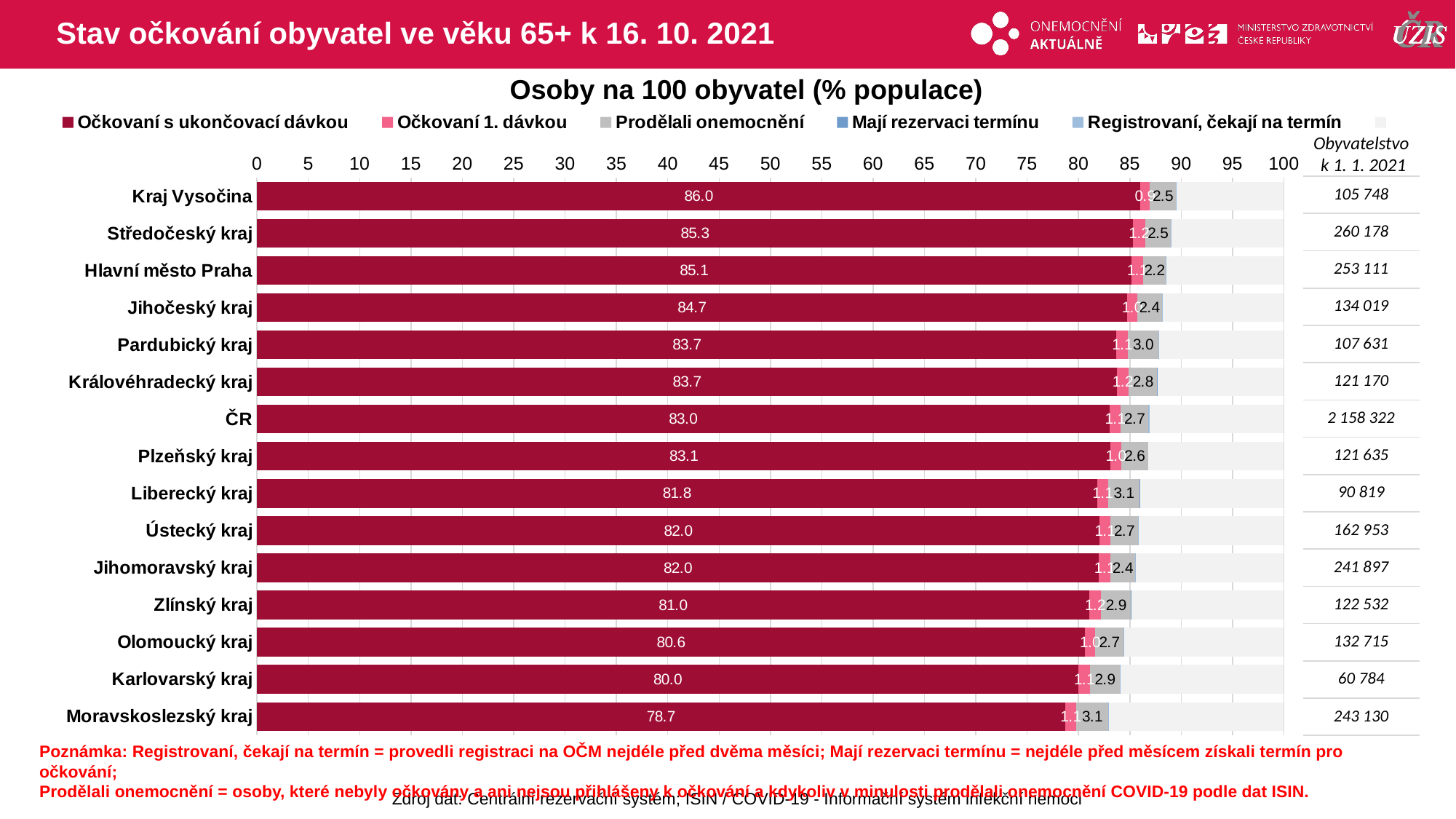
What is the difference between Kraj Vysočina and Moravskoslezský kraj in the 'Očkovaní s ukončovací dávkou' series? 7.3 What is the difference between Olomoucký kraj and Karlovarský kraj in the 'Očkovaní s ukončovací dávkou' series? 0.6 What is the value for Pardubický kraj in the 'Prodělali onemocnění' series? 3.0 Which category has the highest value in the 'Očkovaní s ukončovací dávkou' series? Kraj Vysočina What kind of chart is shown on the slide? Bar chart What is the value for Karlovarský kraj in the 'Očkovaní s ukončovací dávkou' series? 80.0 What is the value for Kraj Vysočina in the 'Očkovaní s ukončovací dávkou' series? 86.0 Which has the larger value in the 'Očkovaní s ukončovací dávkou' series, Středočeský kraj or Hlavní město Praha? Středočeský kraj What is the value for Moravskoslezský kraj in the 'Očkovaní s ukončovací dávkou' series? 78.7 Which category has the lowest value in the 'Očkovaní s ukončovací dávkou' series? Moravskoslezský kraj How many categories are shown on the chart? 15 What is the value for ČR in the 'Očkovaní s ukončovací dávkou' series? 83.0